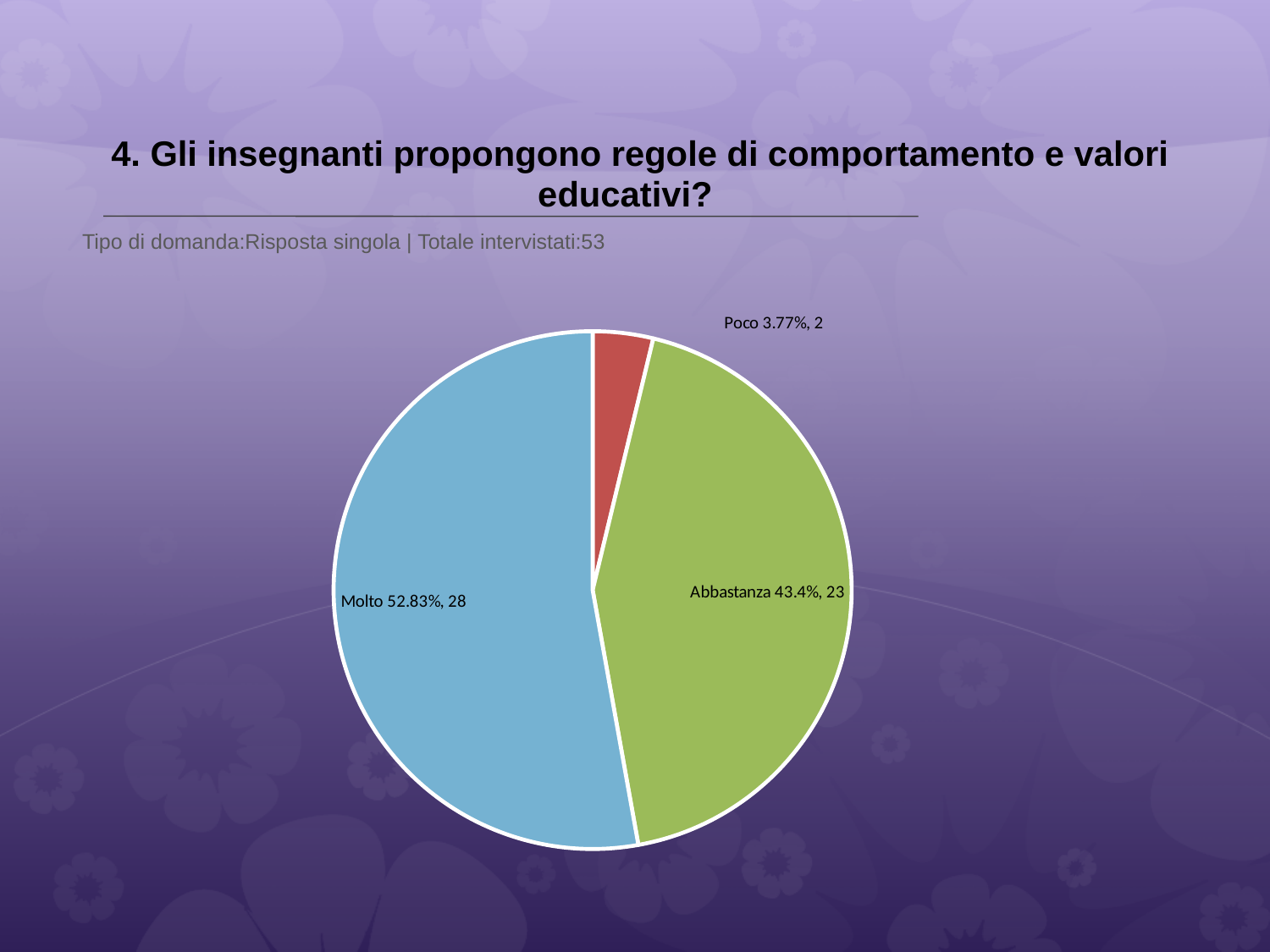
What kind of chart is shown on the slide? pie chart Which category has the largest slice? Molto What is the count for Poco? 2 What is the count for Molto? 28 What percentage is shown for Abbastanza? 43.4% How many slices does the pie chart have? 3 Which is larger, the count for Abbastanza or the count for Poco? Abbastanza What is the total number of respondents across all slices? 53 Which category has the smallest slice? Poco What colour is the Molto slice? blue What percentage is shown for Molto? 52.83% What is the difference in count between Molto and Abbastanza? 5